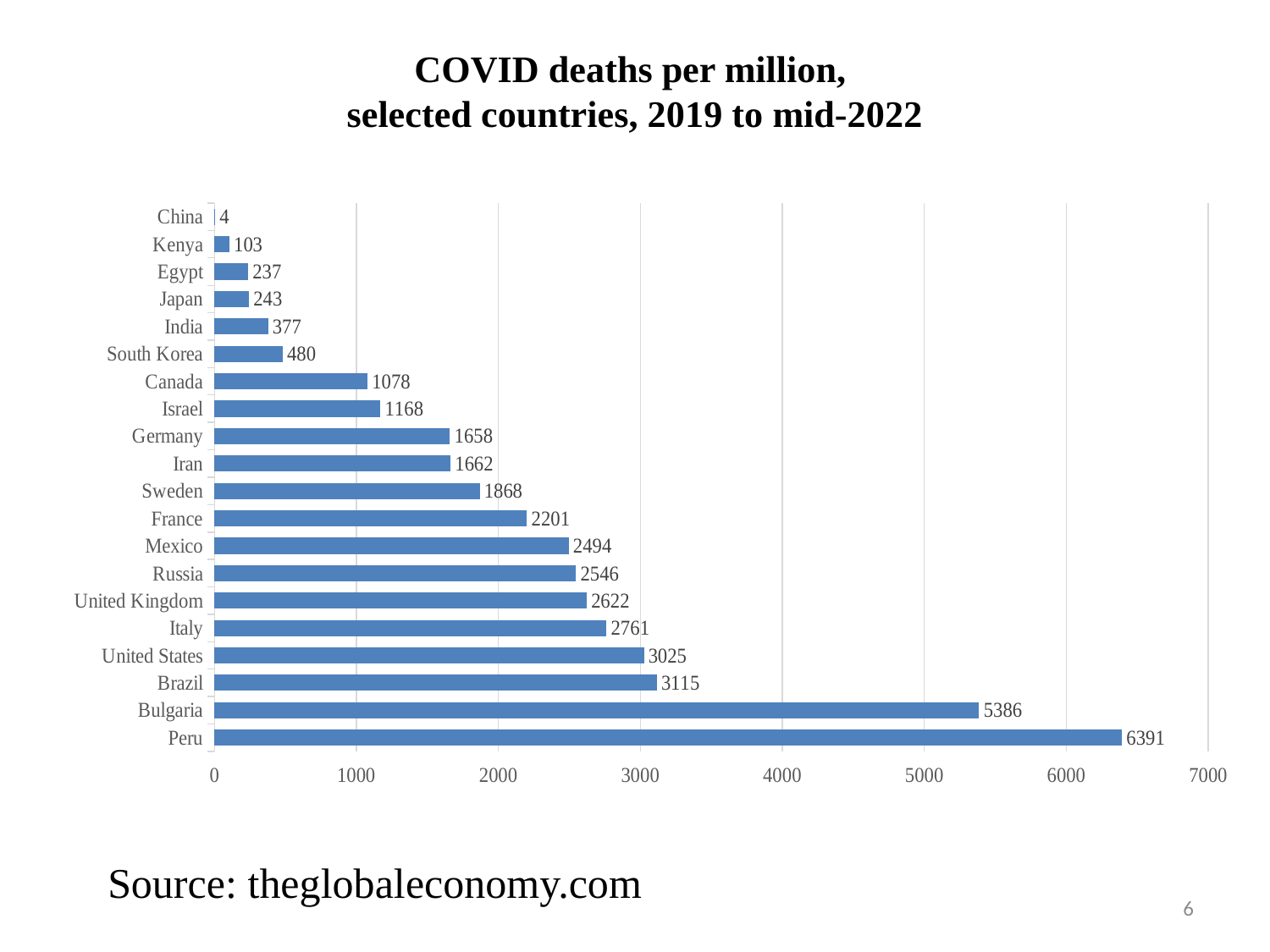
What kind of chart is this? bar chart What is the difference between the values for Brazil and United States? 90 What is the value for South Korea? 480 Which is larger, the value for Italy or the value for United Kingdom? Italy Which country has the lowest value? China What is the value for Germany? 1658 Is the value for Sweden greater or less than 2000? less What is the value for Peru? 6391 How many countries are shown in the chart? 20 Which country has the highest value? Peru What is the difference between the values for Peru and Bulgaria? 1005 What is the title of the chart? COVID deaths per million, selected countries, 2019 to mid-2022